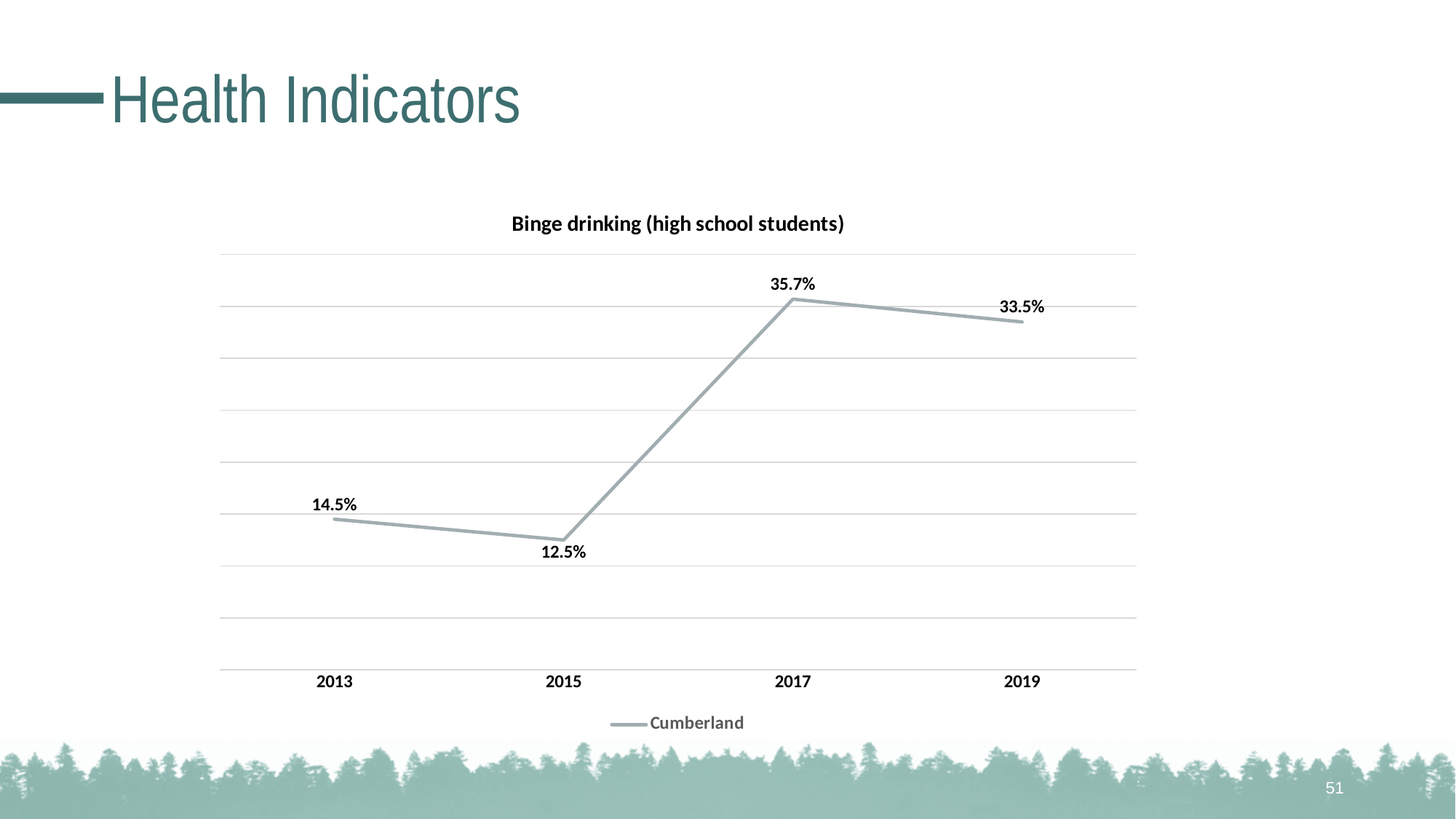
How many series does the legend list? 1 In which year is the binge drinking rate highest? 2017 How many years are plotted on the chart? 4 What kind of chart is shown? Line chart Which year has a higher binge drinking rate, 2013 or 2019? 2019 What is the binge drinking rate for Cumberland in 2017? 35.7% What is the difference between the 2017 and 2015 binge drinking rates? 23.2% What is the title of the chart? Binge drinking (high school students) What is the binge drinking rate for Cumberland in 2019? 33.5% What is the binge drinking rate for Cumberland in 2013? 14.5% What is the binge drinking rate for Cumberland in 2015? 12.5% In which year is the binge drinking rate lowest? 2015